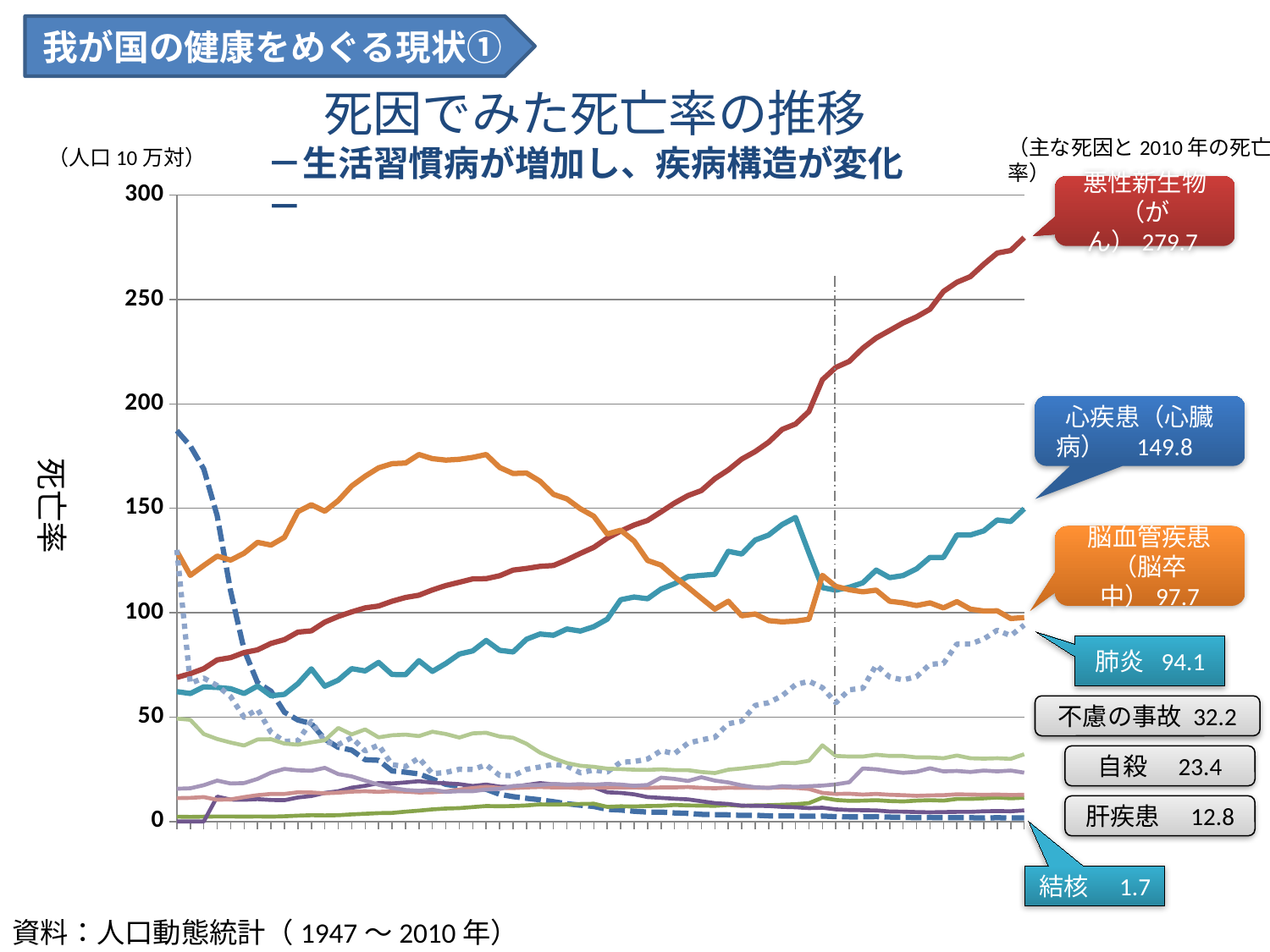
What is the 2010 death rate for 肺炎? 94.1 Which has a higher 2010 death rate, 不慮の事故 or 自殺? 不慮の事故 Is the peak value of the 脳血管疾患（脳卒中） line greater or less than 150? greater Which cause of death has the lowest 2010 death rate? 結核 What is the 2010 death rate for 結核? 1.7 What is the difference between the 2010 death rates for 悪性新生物（がん） and 心疾患（心臓病）? 129.9 What is the 2010 death rate for 心疾患（心臓病）? 149.8 What is the 2010 death rate for 悪性新生物（がん）? 279.7 What is the title of the chart? 死因でみた死亡率の推移 Which cause of death has the highest 2010 death rate? 悪性新生物（がん） What kind of chart is shown on the slide? line chart Does the death rate for 悪性新生物（がん） rise or fall over the period shown? rise